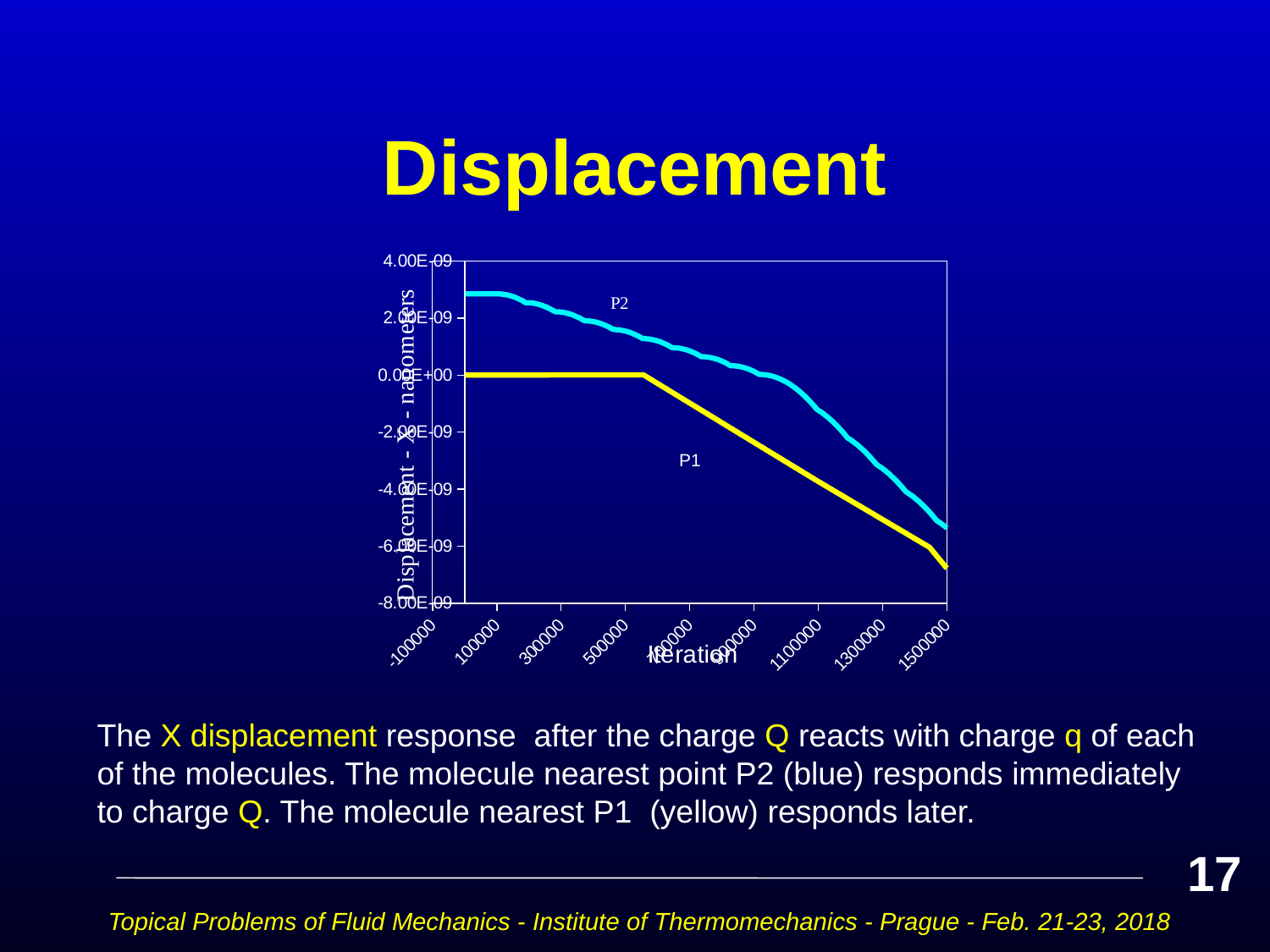
What kind of chart is shown on the slide? line chart Does the P2 series rise or fall as the iteration increases? fall What is the title of the x axis of the chart? Iteration Is the value of P2 at iteration 1500000 greater or less than -6.00E-09? greater At iteration 300000, which series has the larger value, P1 or P2? P2 Which series reaches the lowest displacement value on the chart? P1 Is the value of P1 at iteration 1500000 greater or less than -6.00E-09? less How many data series are plotted on the chart? 2 Which colour is used for the P1 series on the chart? yellow Is the value of P2 at iteration 100000 greater or less than 2.00E-09? greater At iteration 1500000, which series has the larger value, P1 or P2? P2